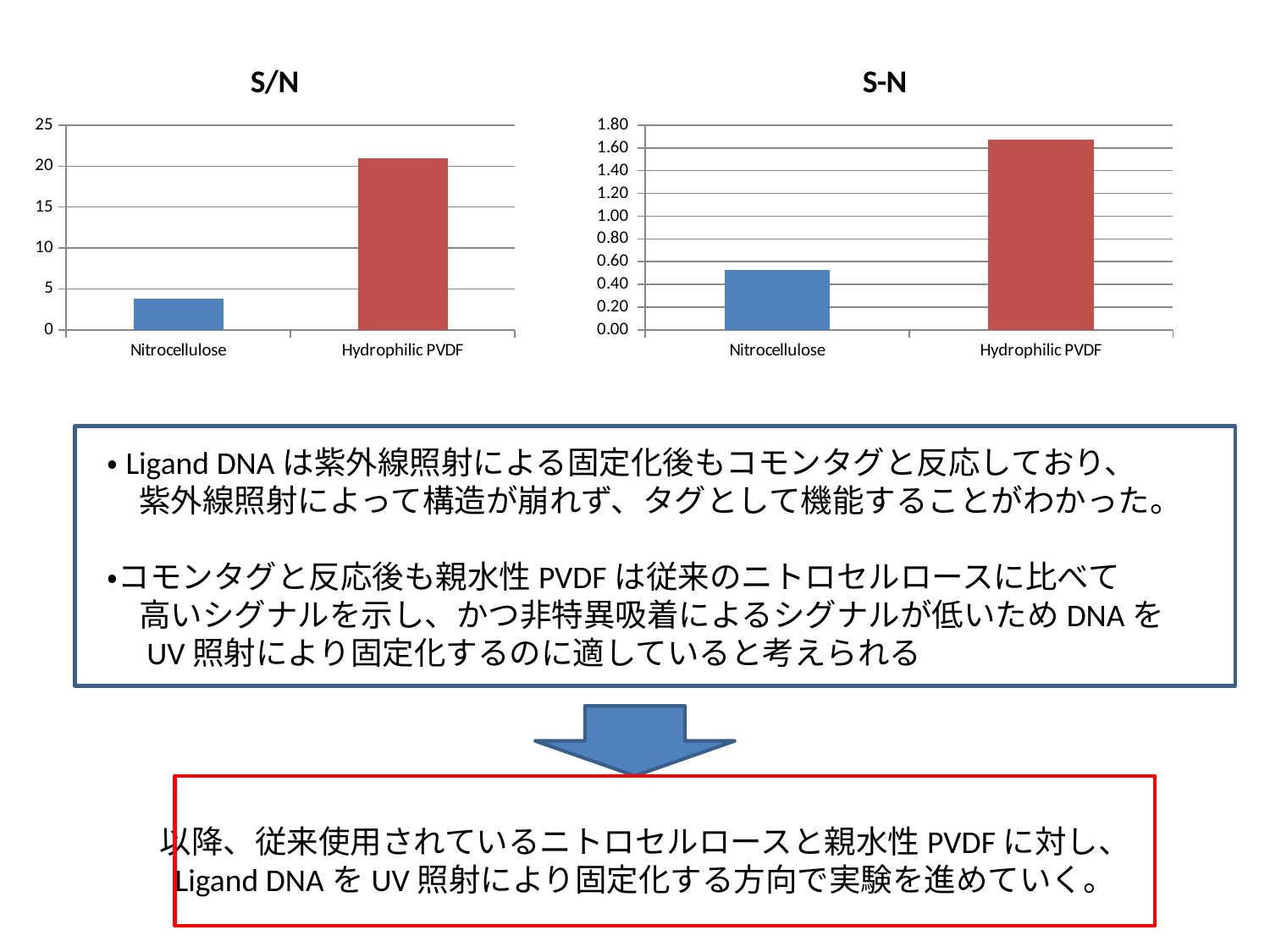
In the S-N chart, is the value for Nitrocellulose greater or less than 0.40? greater What is the title of the chart on the left side of the slide? S/N In the S-N chart, is the value for Hydrophilic PVDF greater or less than 1.40? greater In the S/N chart, which category has the highest value? Hydrophilic PVDF In the S/N chart, is the value for Nitrocellulose greater or less than 5? less In the S/N chart, which category has the lowest value? Nitrocellulose In the S-N chart, which category has the highest value? Hydrophilic PVDF In the S-N chart, which is larger, the value for Nitrocellulose or the value for Hydrophilic PVDF? Hydrophilic PVDF What kind of chart is the S-N chart? bar chart How many categories are shown in the S/N chart? 2